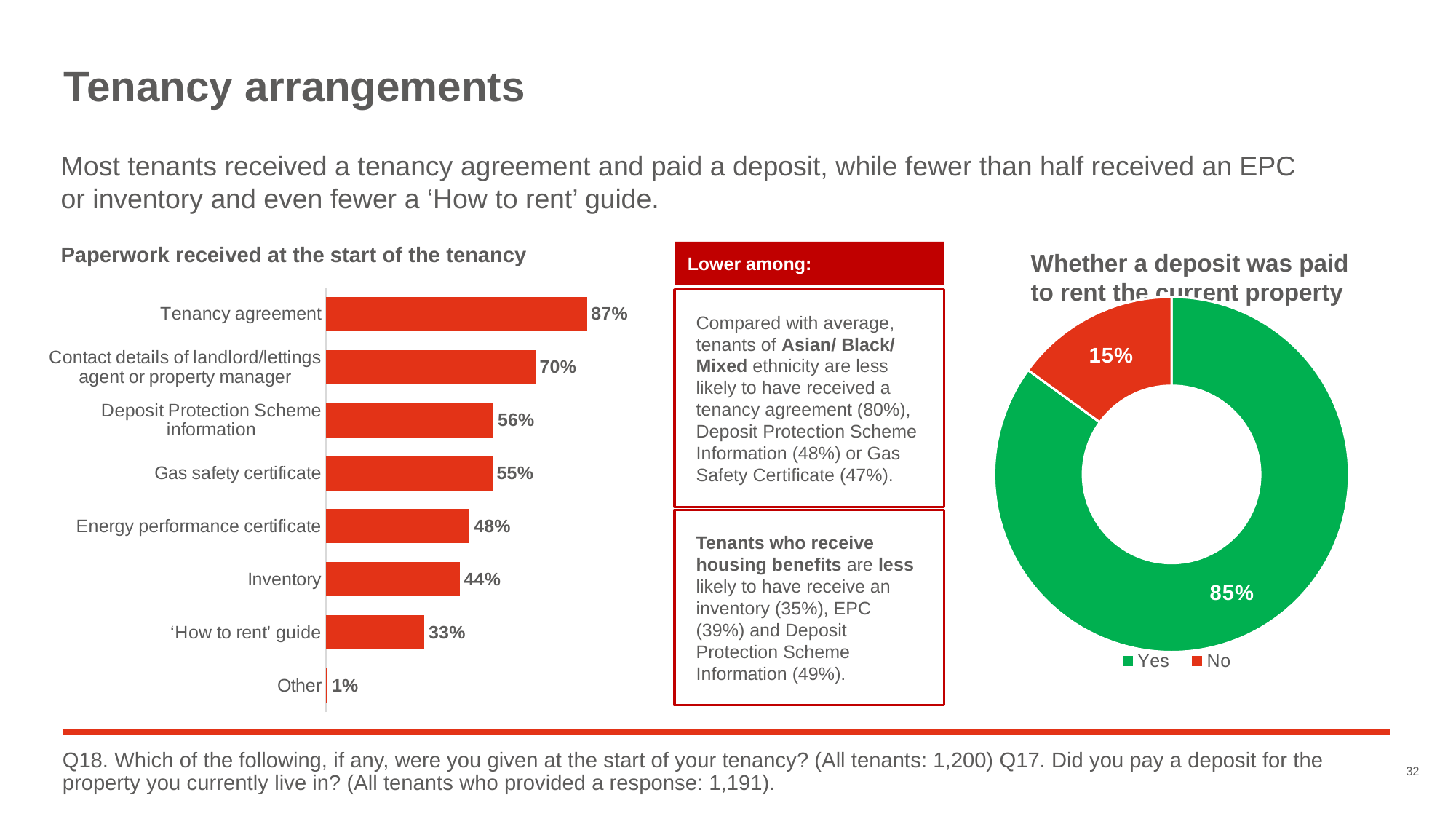
In the 'Paperwork received at the start of the tenancy' chart, which category has the highest value? Tenancy agreement In the 'Paperwork received at the start of the tenancy' chart, what percentage of tenants received a tenancy agreement? 87% In the 'Paperwork received at the start of the tenancy' chart, which is larger: the value for Deposit Protection Scheme information or the value for Inventory? Deposit Protection Scheme information In the 'Whether a deposit was paid to rent the current property' chart, what is the value for No? 15% How many categories are shown in the 'Paperwork received at the start of the tenancy' chart? 8 In the 'Whether a deposit was paid to rent the current property' chart, what share of tenants answered Yes? 85% In the 'Paperwork received at the start of the tenancy' chart, what is the value for Inventory? 44% In the 'Paperwork received at the start of the tenancy' chart, what is the difference between the values for Tenancy agreement and Energy performance certificate? 39% In the 'Paperwork received at the start of the tenancy' chart, which category has the lowest value? Other What kind of chart is 'Paperwork received at the start of the tenancy'? Bar chart How many entries does the legend of the 'Whether a deposit was paid to rent the current property' chart list? 2 In the 'Paperwork received at the start of the tenancy' chart, what is the value for 'How to rent' guide? 33%